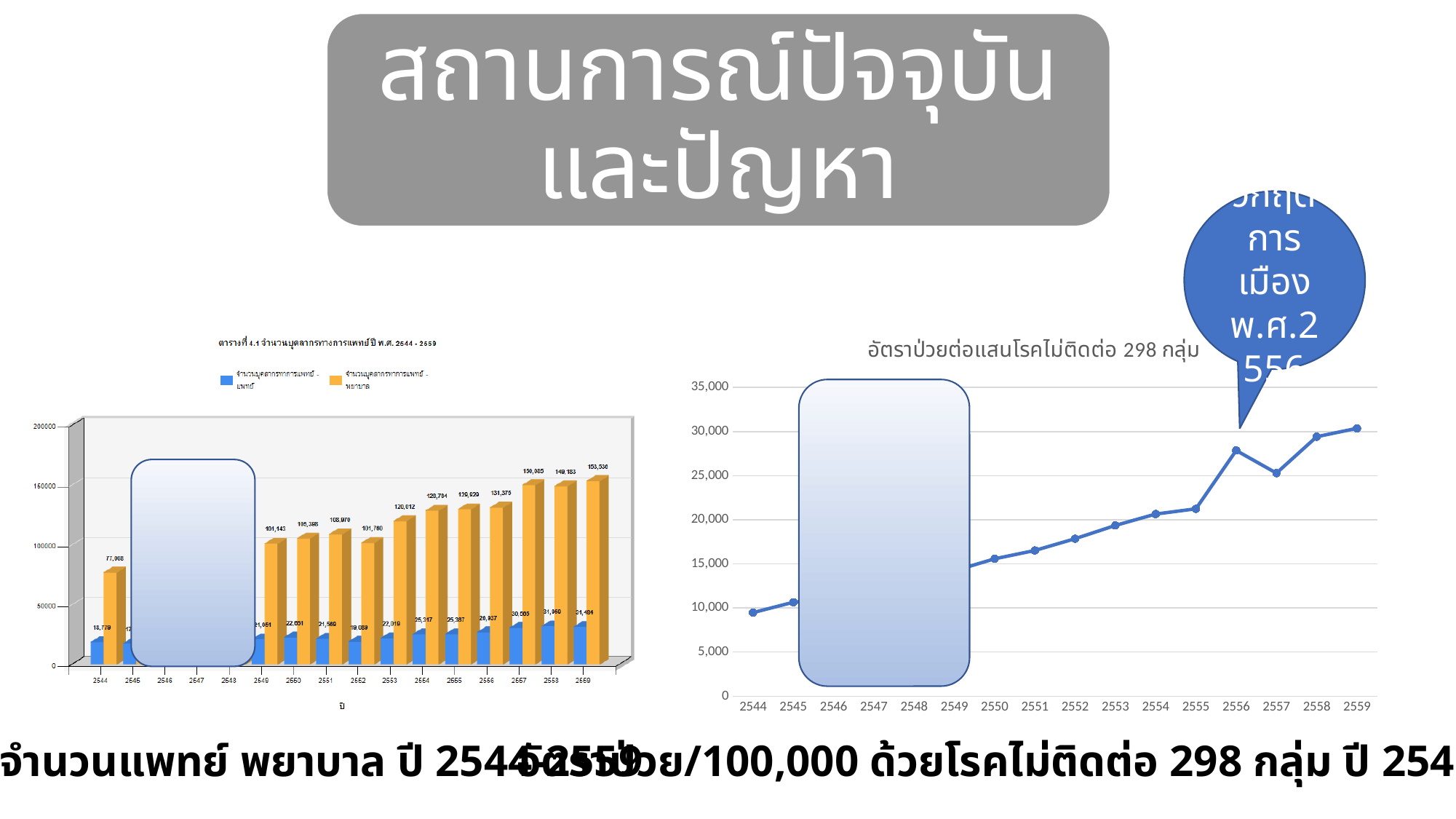
In the right line chart, is the value for 2556 greater or less than 25,000? greater In the right line chart, which year has the larger value, 2556 or 2557? 2556 What kind of chart is the left chart (จำนวนบุคลากรทางการแพทย์)? bar chart In the right line chart, is the value for 2544 greater or less than 10,000? less In the right line chart, is the value for 2557 greater or less than 30,000? less How many series does the legend of the left bar chart list? 2 What is the title of the right line chart? อัตราป่วยต่อแสนโรคไม่ติดต่อ 298 กลุ่ม What kind of chart is the right chart (อัตราป่วยต่อแสนโรคไม่ติดต่อ 298 กลุ่ม)? line chart In the right line chart, which year has the lowest value? 2544 In the right line chart, do the values generally rise or fall from 2544 to 2559? rise In the right line chart, which year has the highest value? 2559